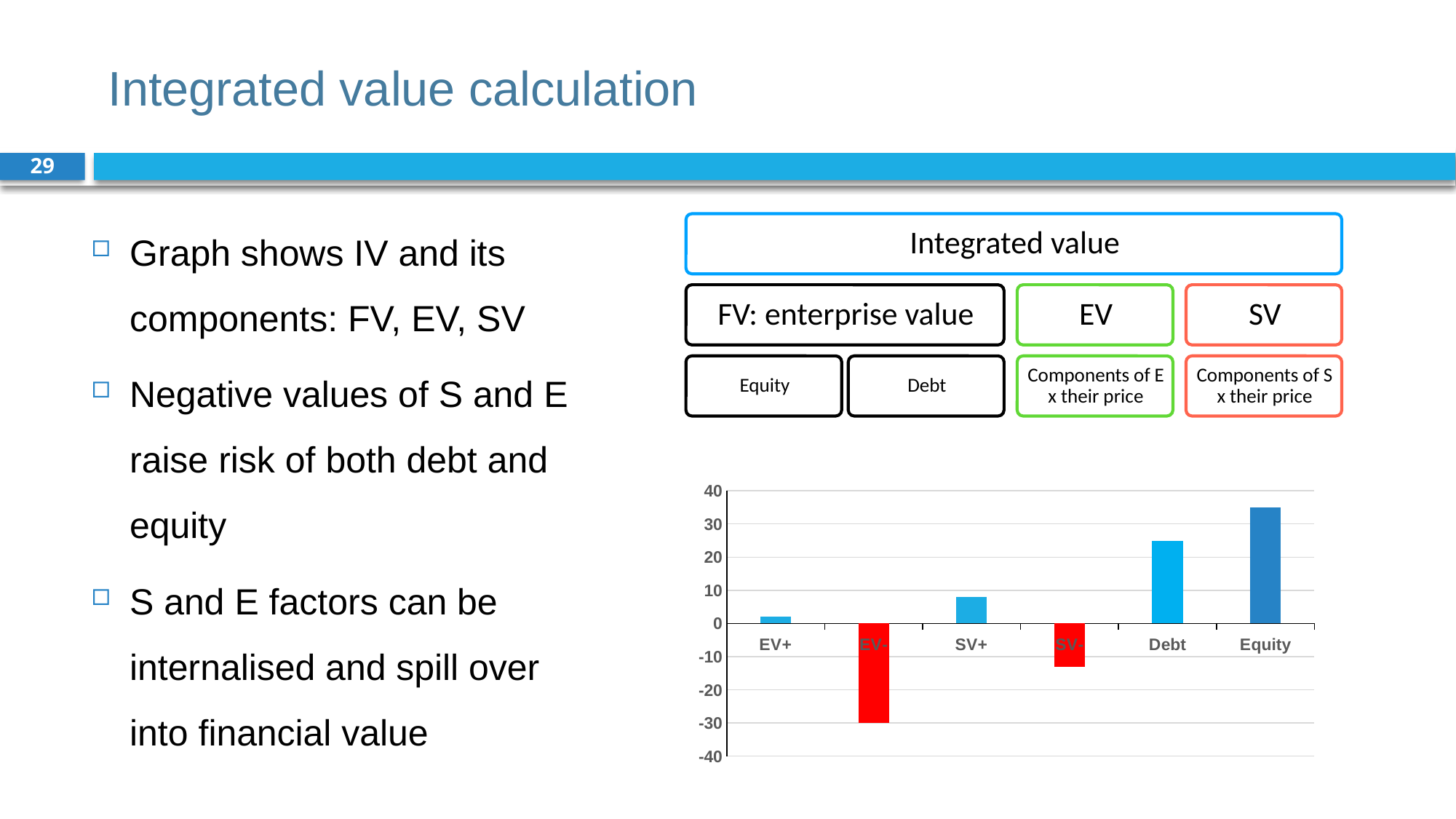
Which category has the highest value in the bar chart? Equity Is the value for Debt greater or less than 20? greater Is the value for SV- greater or less than -10? less What colour are the bars with negative values in the chart? red What is the value for EV- in the bar chart? -30 Is the value for Equity greater or less than 30? greater How many categories are shown on the x axis of the bar chart? 6 Which is larger, the value for Debt or the value for Equity? Equity What kind of chart is shown on the slide? bar chart Which category has the lowest value in the bar chart? EV- Which is larger, the value for EV+ or the value for SV+? SV+